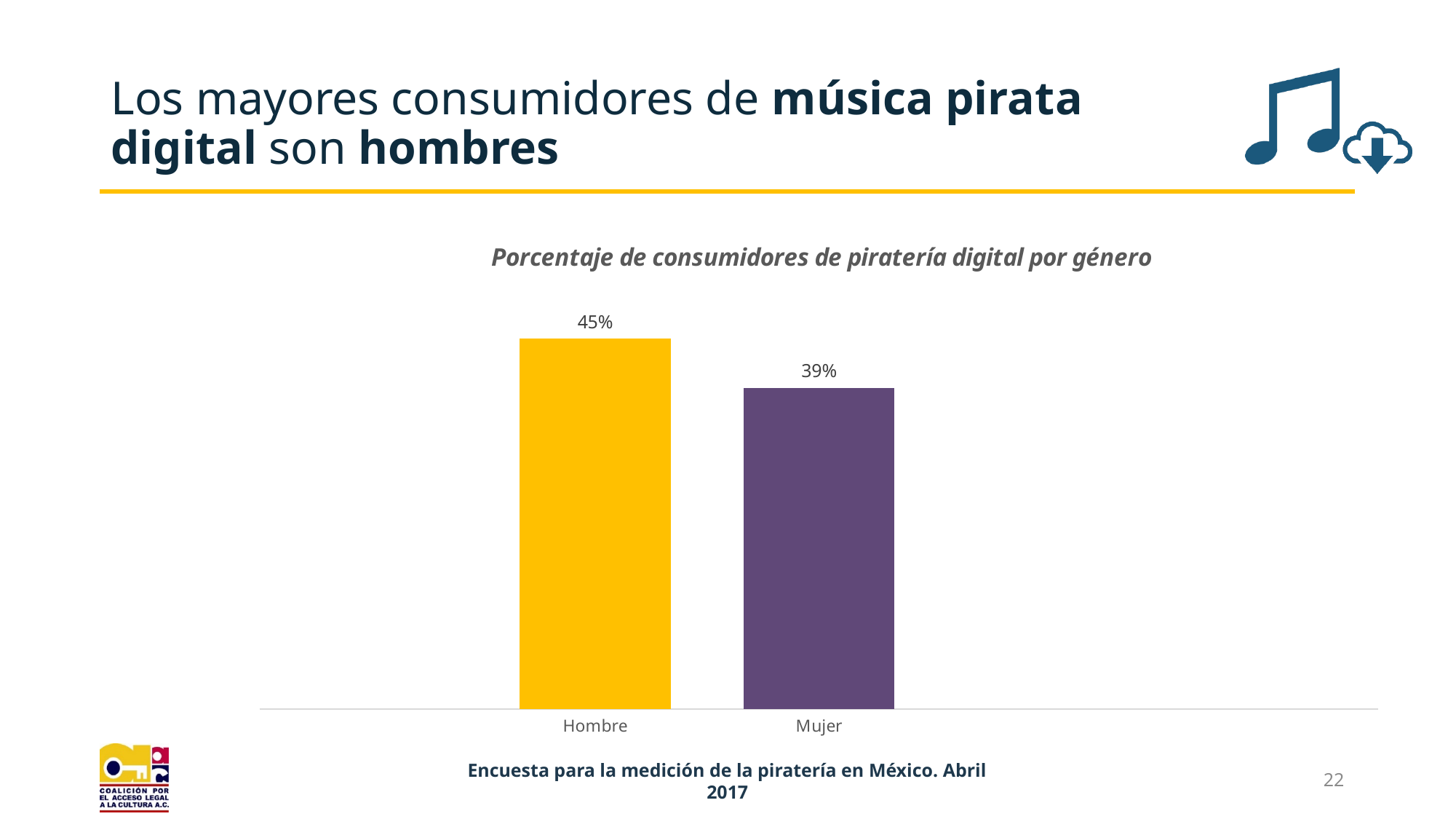
Which category has the highest value? Hombre What is the value for Hombre? 45% Which is larger, the value for Hombre or the value for Mujer? Hombre Which category has the lowest value? Mujer What is the difference between the values for Hombre and Mujer? 6% What colour is the bar for Hombre? Yellow What is the title of the chart? Porcentaje de consumidores de piratería digital por género What kind of chart is shown on the slide? Bar chart What is the value for Mujer? 39% How many categories are shown in the chart? 2